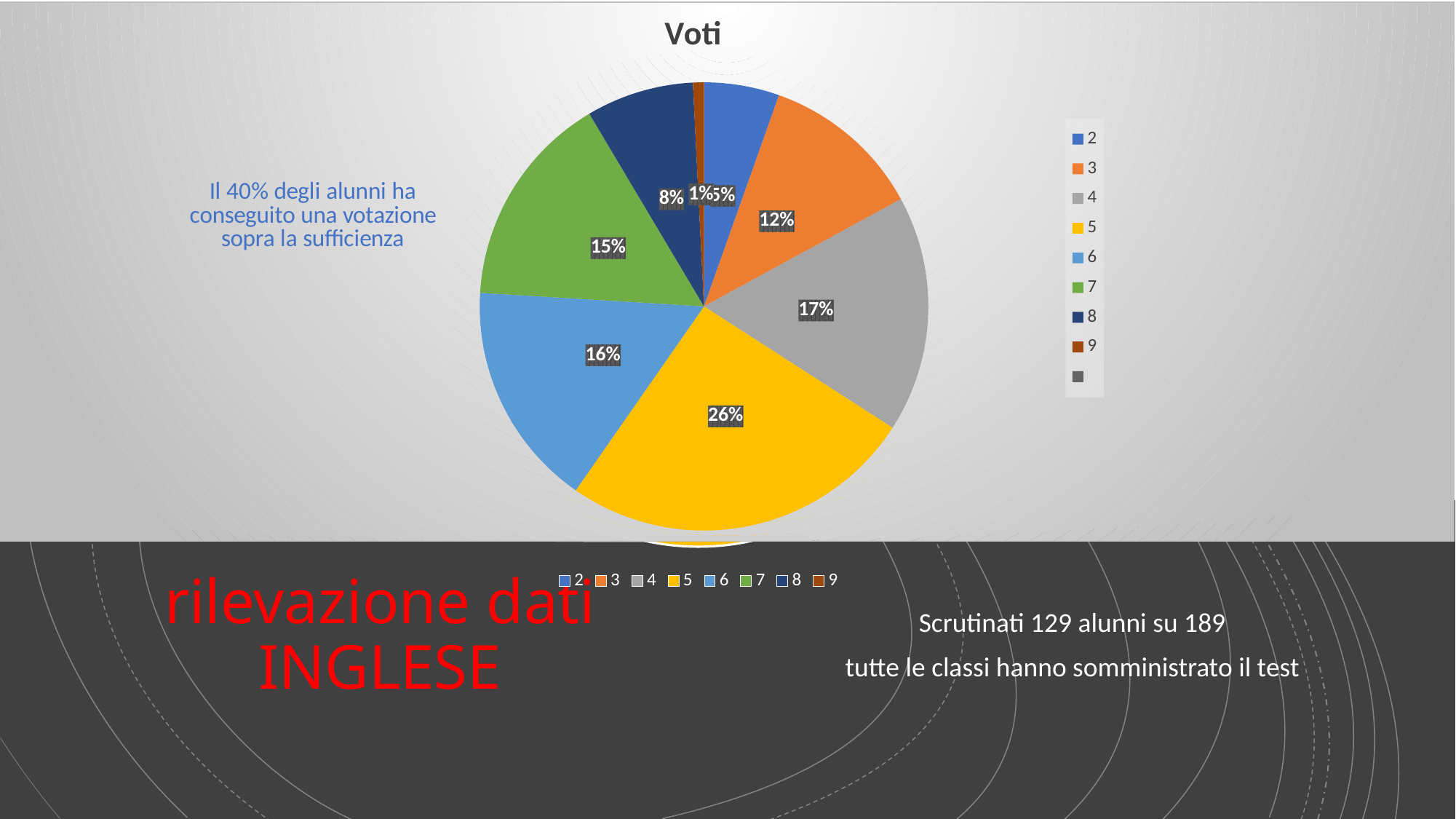
What share of the pie does grade 5 take? 26% What kind of chart is shown on the slide? pie chart What percentage is shown for grade 4? 17% Which grade has the smallest slice of the pie? 9 Which slice is larger, grade 3 or grade 7? 7 Which grade has the largest slice of the pie? 5 What is the title of the chart? Voti What is the difference in percentage points between grade 5 and grade 3? 14 What colour is the slice for grade 5? yellow What percentage is shown for grade 6? 16% What percentage is shown for grade 8? 8% What is the combined share of grades 2 and 3? 17%